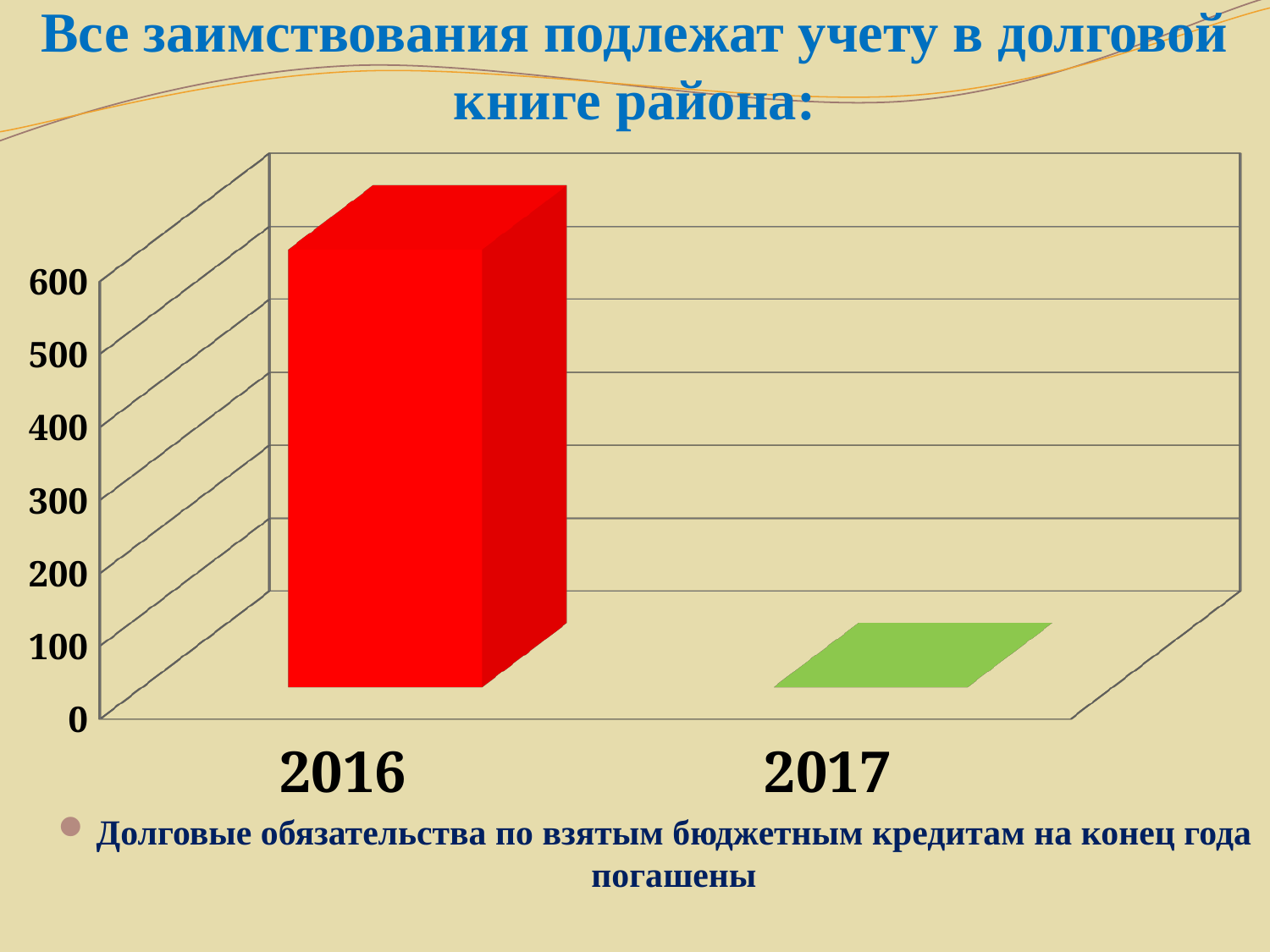
Do the values rise or fall from 2016 to 2017? fall How many categories are shown on the x axis of the chart? 2 Is the value for 2017 greater or less than 100? less Is the value for 2016 greater or less than 500? greater What is the value for 2017 in the chart? 0 What is the title of the slide? Все заимствования подлежат учету в долговой книге района: Is the value for 2016 greater or less than 300? greater What kind of chart is shown on the slide? bar chart Which year has the lowest value in the chart? 2017 What colour is the bar for 2016? red Which year has the highest value in the chart? 2016 Which year has the larger value, 2016 or 2017? 2016